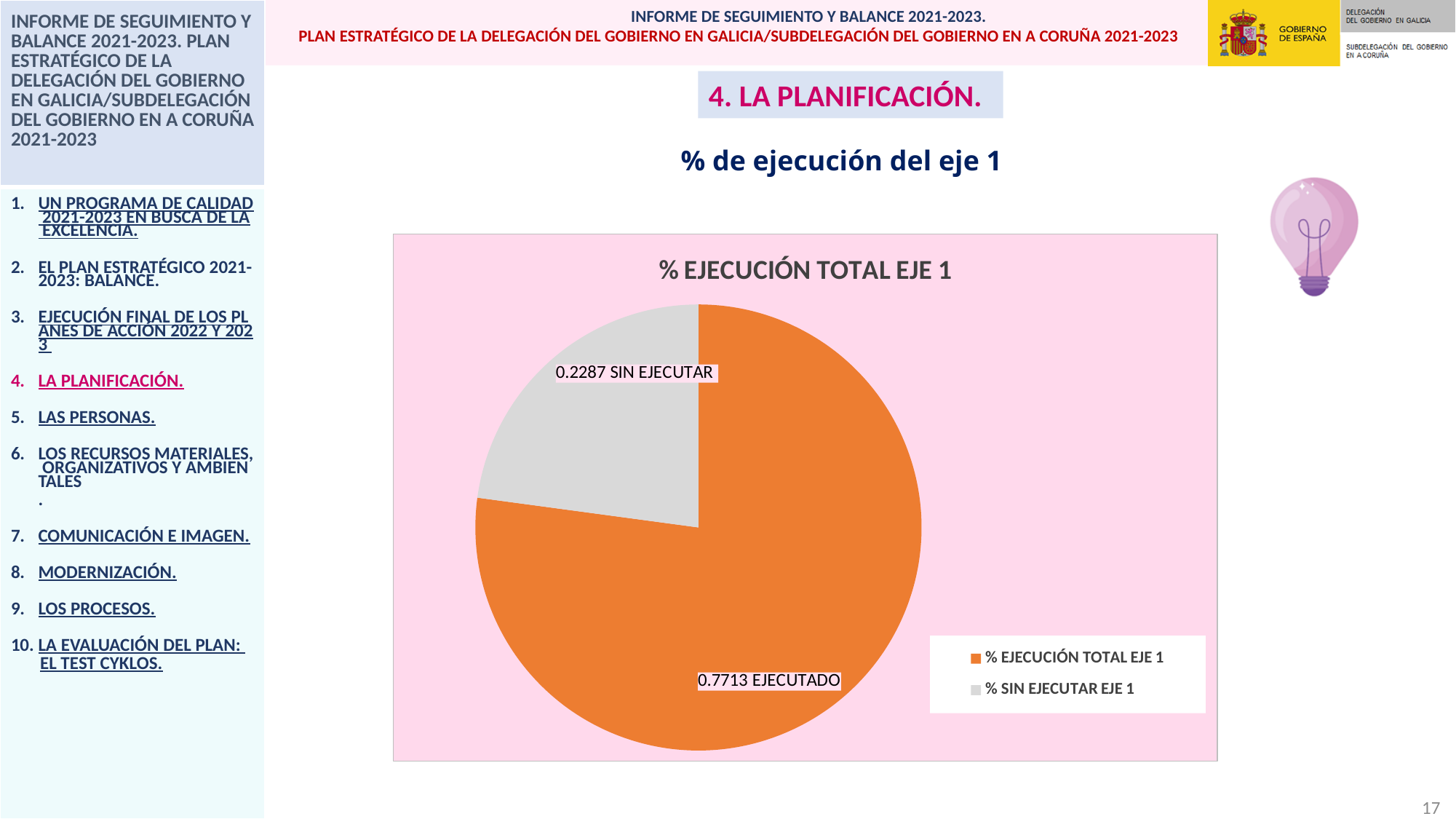
What is the difference between the EJECUTADO value and the SIN EJECUTAR value? 0.5426 Which is larger, the EJECUTADO slice or the SIN EJECUTAR slice? EJECUTADO What is the total of the two slice values shown on the pie chart? 1 What value is shown for the SIN EJECUTAR slice? 0.2287 What type of chart is shown on the slide? pie chart What colour is the % SIN EJECUTAR EJE 1 slice? grey What is the title of the chart? % EJECUCIÓN TOTAL EJE 1 What value is shown for the EJECUTADO slice? 0.7713 How many slices does the pie chart have? 2 Which slice is the smallest in the pie chart? SIN EJECUTAR Which slice is the largest in the pie chart? EJECUTADO How many entries does the legend list? 2